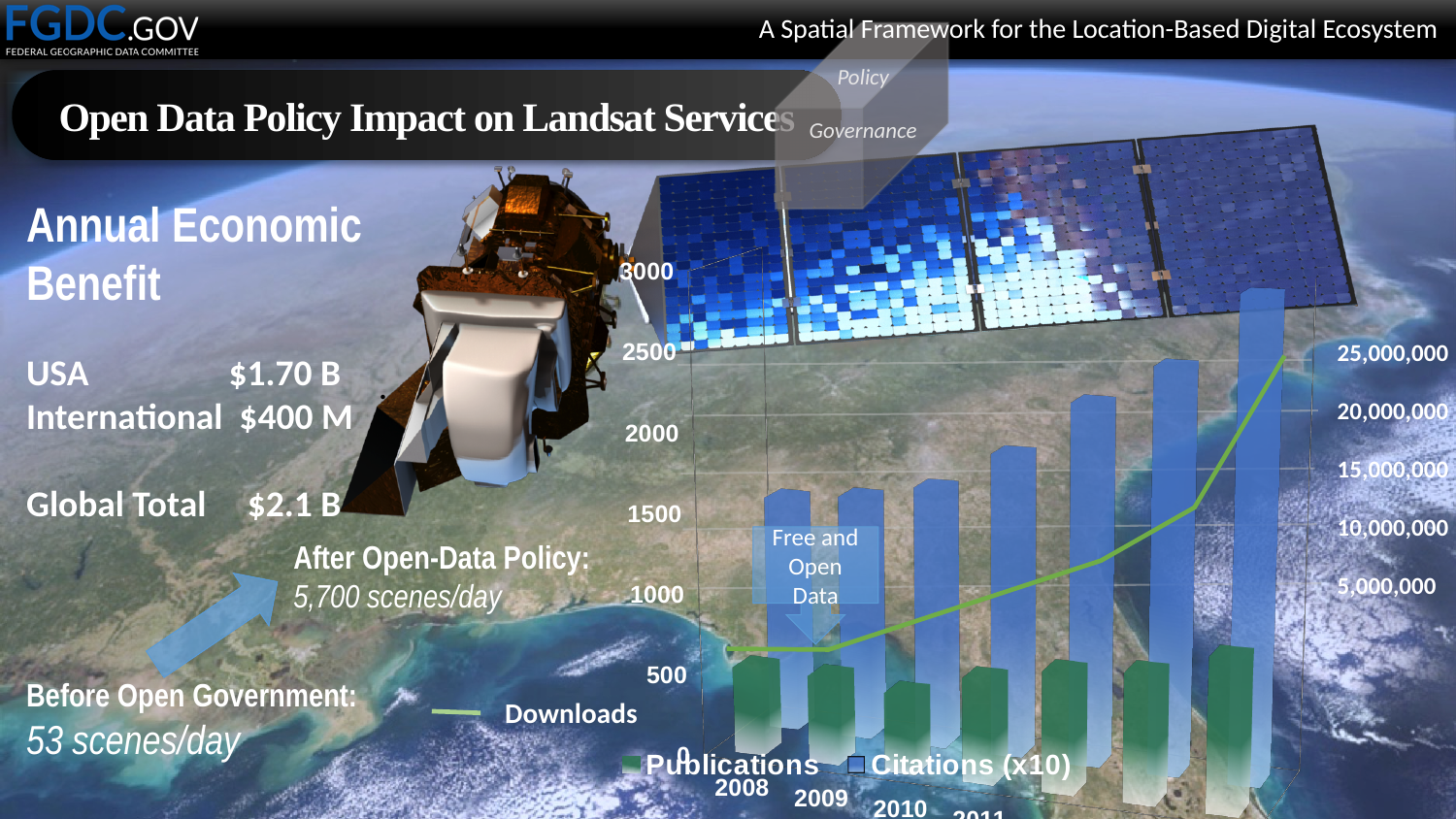
Which series is drawn as a line in the chart? Downloads How many series does the chart's legend list? 2 Does the Downloads line rise or fall from 2008 onward? rise Which year has the larger Citations (x10) bar, 2008 or 2011? 2011 Is the Downloads value at the start of the line (2008) greater or less than 5,000,000? less What kind of chart is shown on the slide? bar and line chart Is the Publications value for 2008 greater or less than 1000? less Which is larger in 2008, the Publications bar or the Citations (x10) bar? Citations (x10) What is the label of the blue bar series in the legend? Citations (x10) Do the Citations (x10) bars rise or fall from 2008 to 2011? rise Is the Downloads value at the right end of the line greater or less than 20,000,000? greater